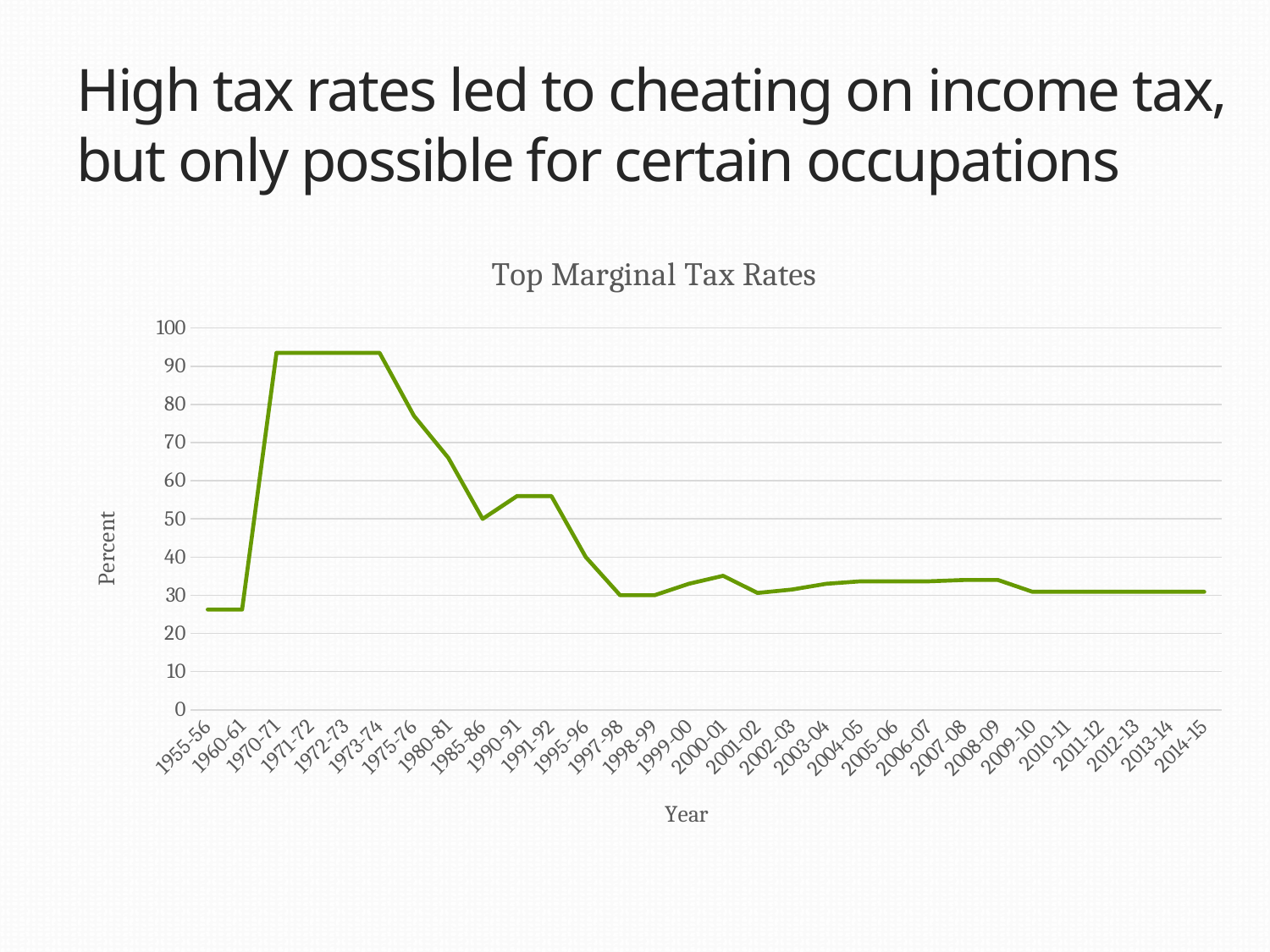
What is the title of the chart? Top Marginal Tax Rates Do the values rise or fall between 1973-74 and 1997-98? fall Is the value for 2014-15 greater or less than 40? less What is the label on the vertical axis of the chart? Percent Is the value for 1980-81 greater or less than 70? less Is the value for 1995-96 greater or less than 50? less How many years are plotted along the x axis? 30 Which is larger, the value for 1980-81 or the value for 1990-91? 1980-81 What kind of chart is shown on the slide? line chart